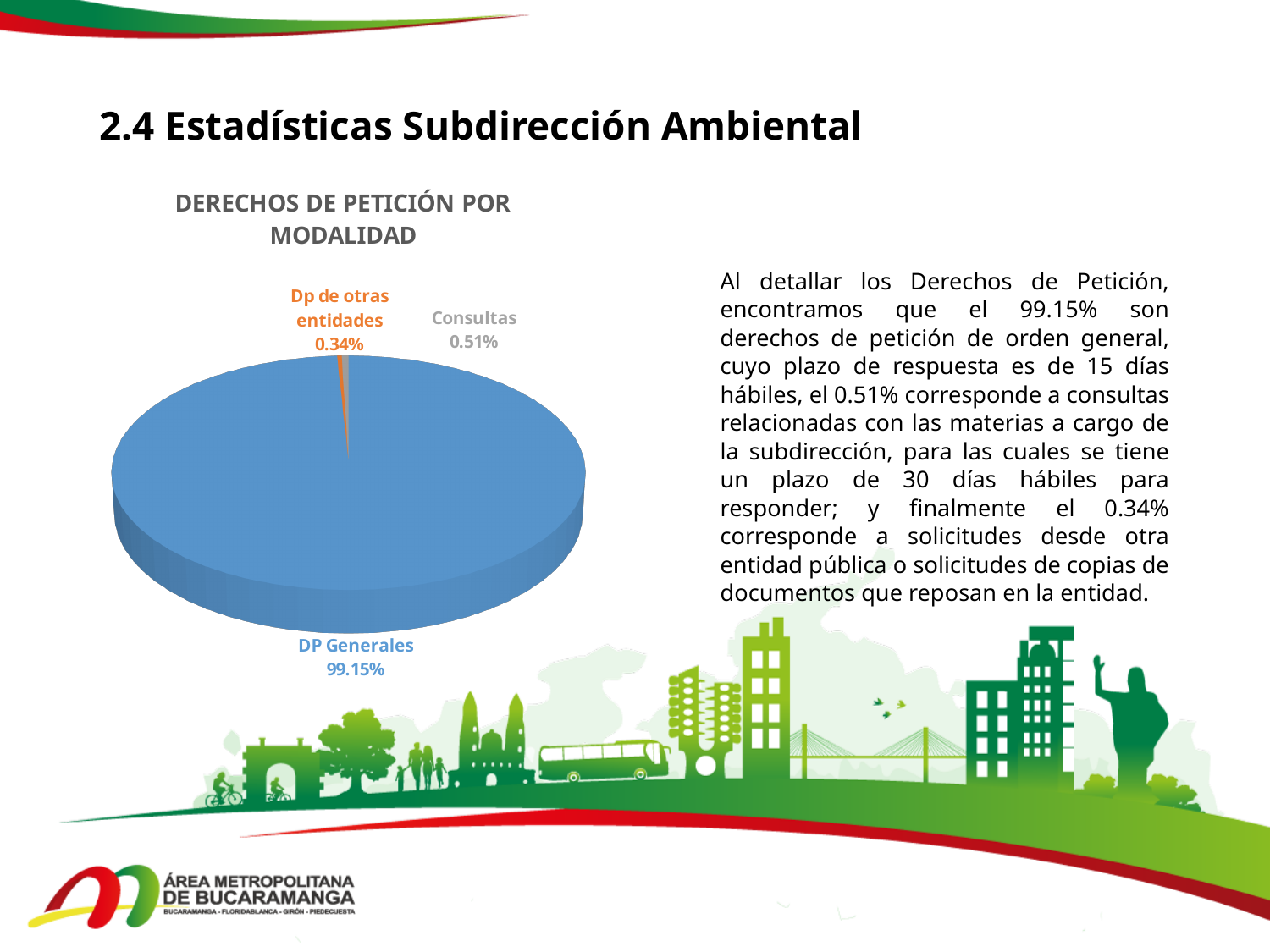
Which is larger, the share for Consultas or the share for Dp de otras entidades? Consultas What is the value shown for Consultas? 0.51% What share of the pie does DP Generales represent? 99.15% What type of chart is shown on the slide? Pie chart How many categories are shown in the pie chart? 3 Which category has the smallest share of the pie? Dp de otras entidades What is the value shown for Dp de otras entidades? 0.34% What is the difference between the share for Consultas and the share for Dp de otras entidades? 0.17% What is the title of the chart? DERECHOS DE PETICIÓN POR MODALIDAD What colour is the DP Generales slice? Blue What is the difference between the share for DP Generales and the share for Consultas? 98.64% Which category has the largest share of the pie? DP Generales